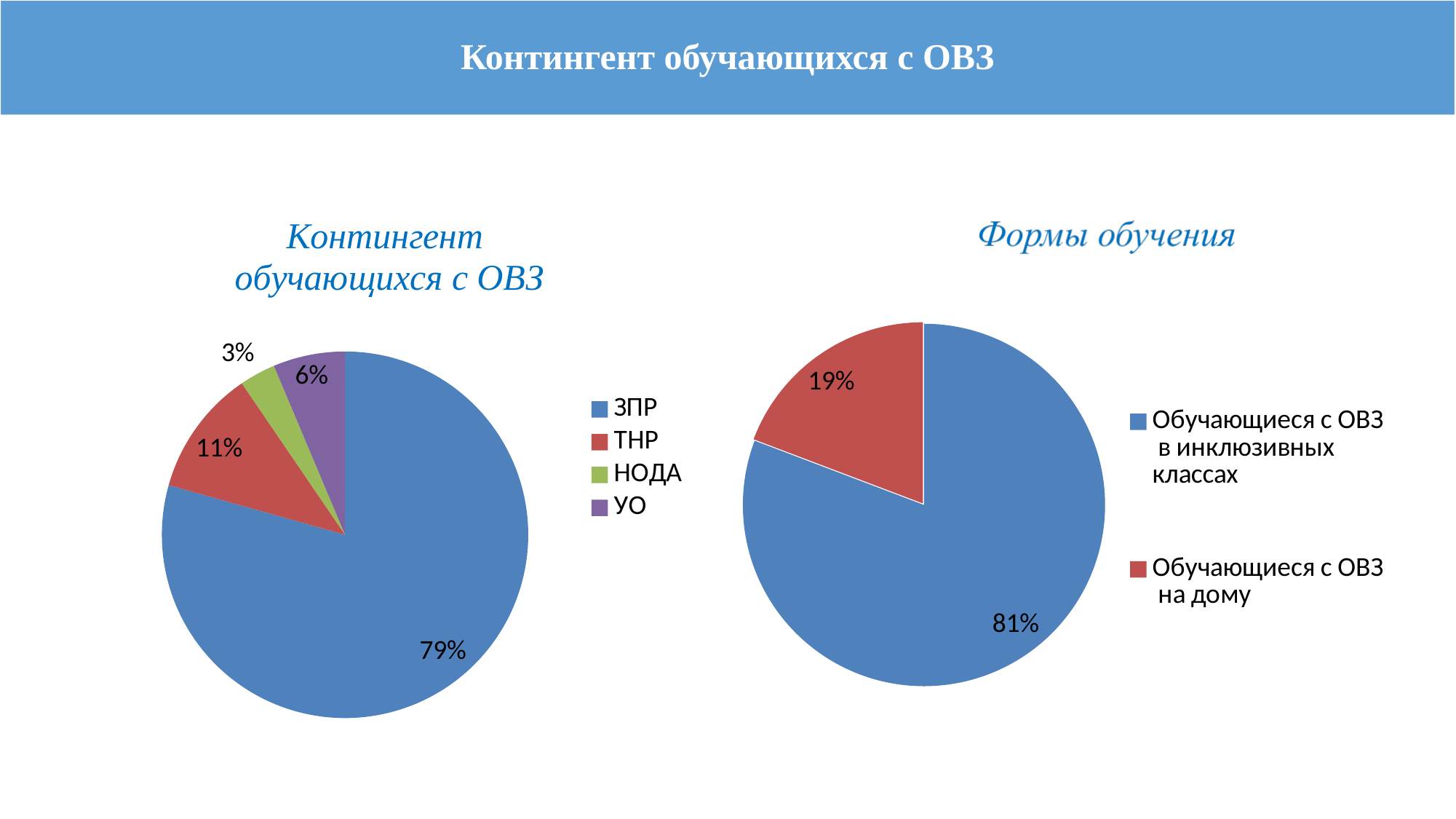
In the chart titled "Контингент обучающихся с ОВЗ", what share of the pie is ЗПР? 79% In the chart titled "Контингент обучающихся с ОВЗ", how many categories does the legend list? 4 What kind of chart is the chart titled "Формы обучения"? Pie chart In the chart titled "Контингент обучающихся с ОВЗ", which category has the largest slice? ЗПР In the chart titled "Формы обучения", what share of the pie is "Обучающиеся с ОВЗ в инклюзивных классах"? 81% In the chart titled "Контингент обучающихся с ОВЗ", what share of the pie is НОДА? 3% In the chart titled "Контингент обучающихся с ОВЗ", which category has the smallest slice? НОДА In the chart titled "Контингент обучающихся с ОВЗ", what is the difference in percentage points between ТНР and УО? 5 In the chart titled "Формы обучения", which is larger: the slice for students in inclusive classes or the slice for students studying at home? Обучающиеся с ОВЗ в инклюзивных классах